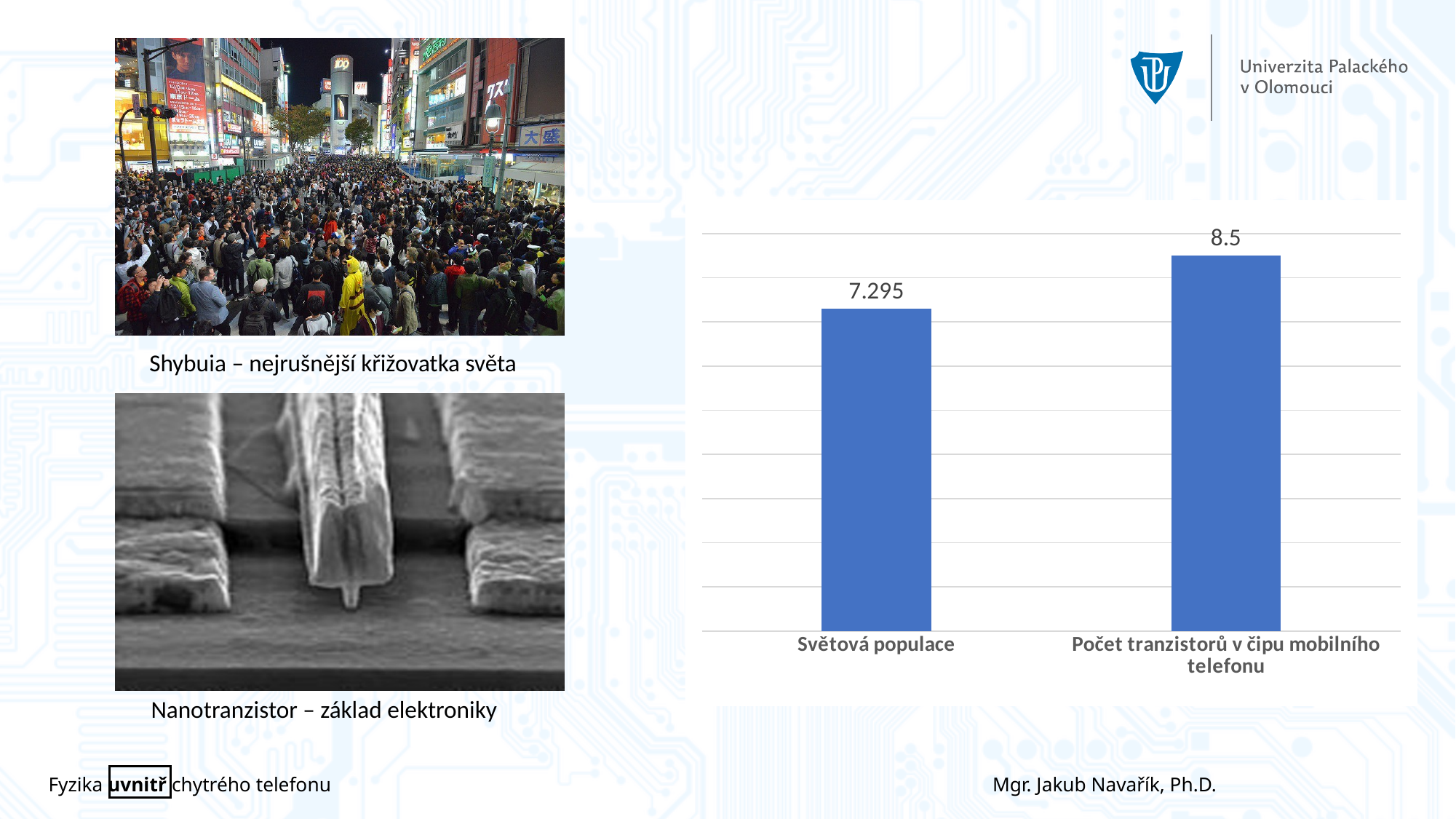
Which category has the highest value? Počet tranzistorů v čipu mobilního telefonu Which category has the lowest value? Světová populace What kind of chart is shown on the slide? Bar chart Which is larger: the value for Světová populace or the value for Počet tranzistorů v čipu mobilního telefonu? Počet tranzistorů v čipu mobilního telefonu What is the value shown for Světová populace? 7.295 What is the label of the left-hand bar in the chart? Světová populace How many categories are plotted in the chart? 2 What colour are the bars in the chart? Blue What is the value shown for Počet tranzistorů v čipu mobilního telefonu? 8.5 What is the difference between the value for Počet tranzistorů v čipu mobilního telefonu and the value for Světová populace? 1.205 Do the values rise or fall from left to right across the categories? Rise